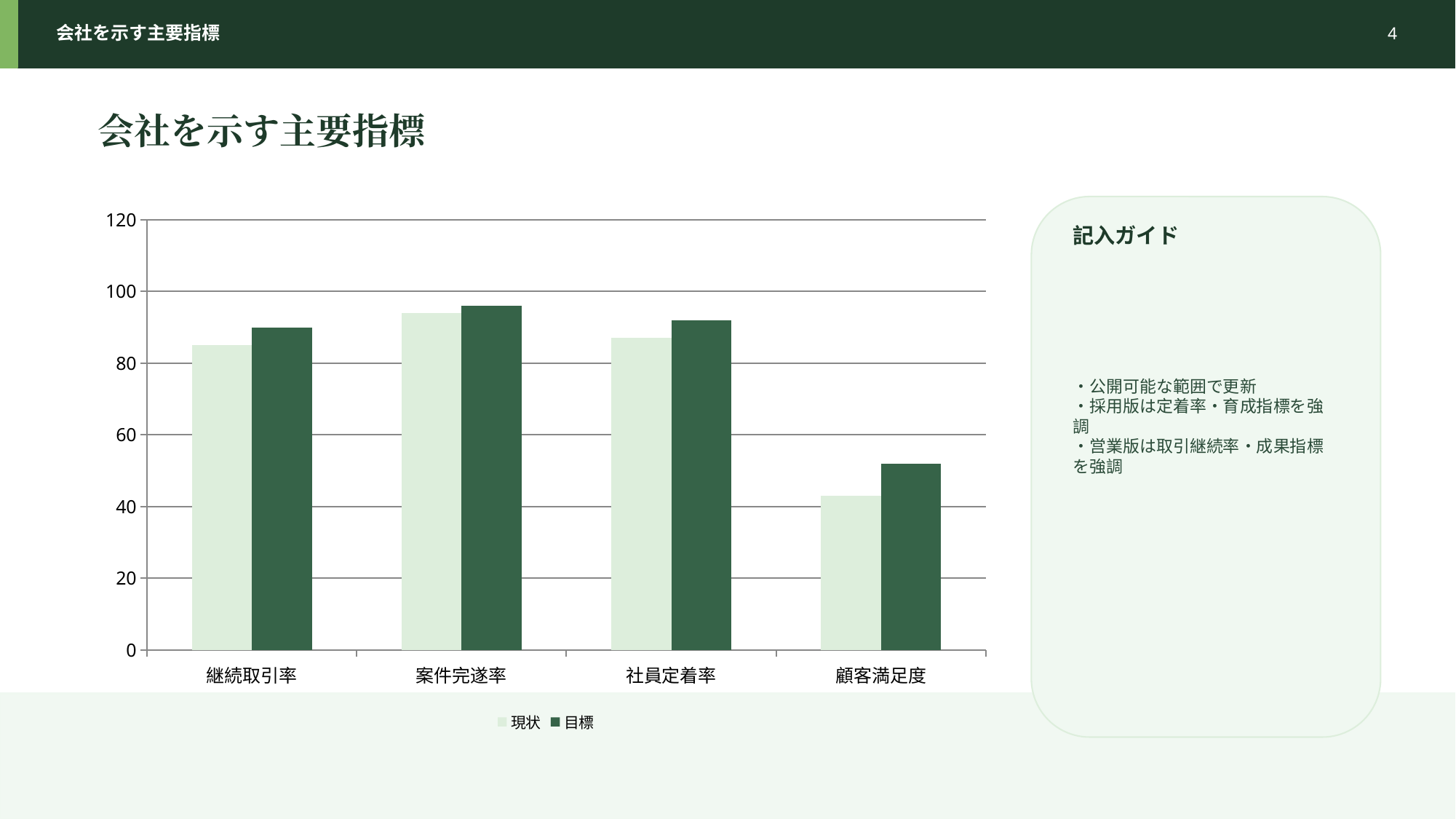
Is the 現状 value for 顧客満足度 greater or less than 60? less How many categories are shown on the x axis of the chart? 4 How many series does the chart's legend list? 2 Which is larger: the 現状 value for 案件完遂率 or the 現状 value for 顧客満足度? 案件完遂率 Which category has the highest 目標 value? 案件完遂率 What are the two legend entries of the chart? 現状 and 目標 Is the 現状 value for 継続取引率 greater or less than 100? less Is the 目標 value for 案件完遂率 greater or less than 80? greater What kind of chart is shown on the slide? bar chart Which category has the lowest 目標 value? 顧客満足度 Which category has the lowest 現状 value? 顧客満足度 For 顧客満足度, which is larger: the 現状 value or the 目標 value? 目標